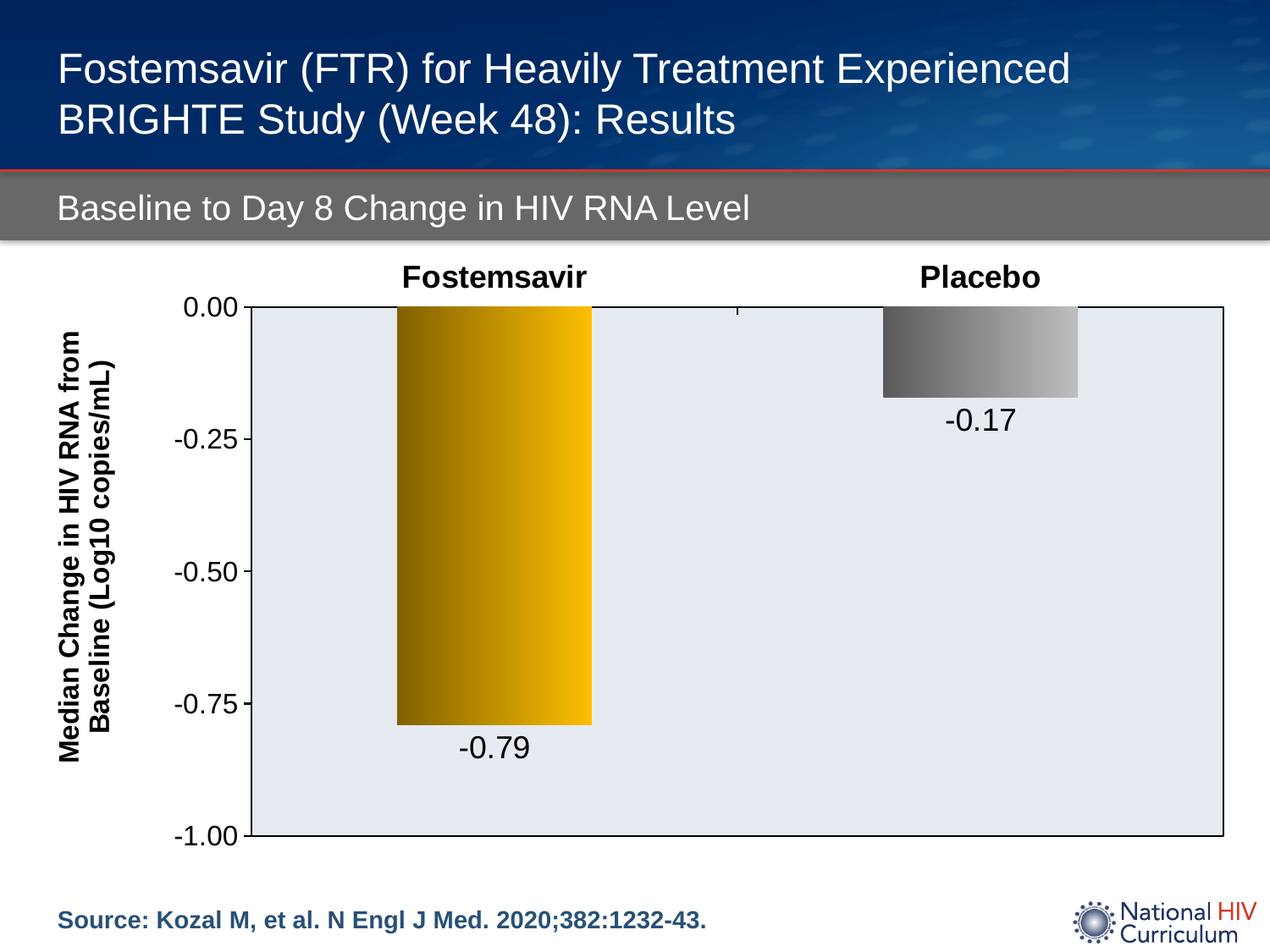
What is the difference between the Fostemsavir and Placebo median changes in HIV RNA? 0.62 What is the label of the vertical axis? Median Change in HIV RNA from Baseline (Log10 copies/mL) What is the median change in HIV RNA from baseline for Fostemsavir? -0.79 How many groups are plotted in the chart? 2 Is the decrease in HIV RNA larger for Fostemsavir or for Placebo? Fostemsavir Which group shows the larger decrease in HIV RNA from baseline? Fostemsavir What kind of chart is shown on the slide? Bar chart Is the value for Placebo greater or less than -0.25? greater What is the title shown above the chart? Baseline to Day 8 Change in HIV RNA Level Is the value for Fostemsavir greater or less than -0.50? less Which group shows the smaller decrease in HIV RNA from baseline? Placebo What is the median change in HIV RNA from baseline for Placebo? -0.17